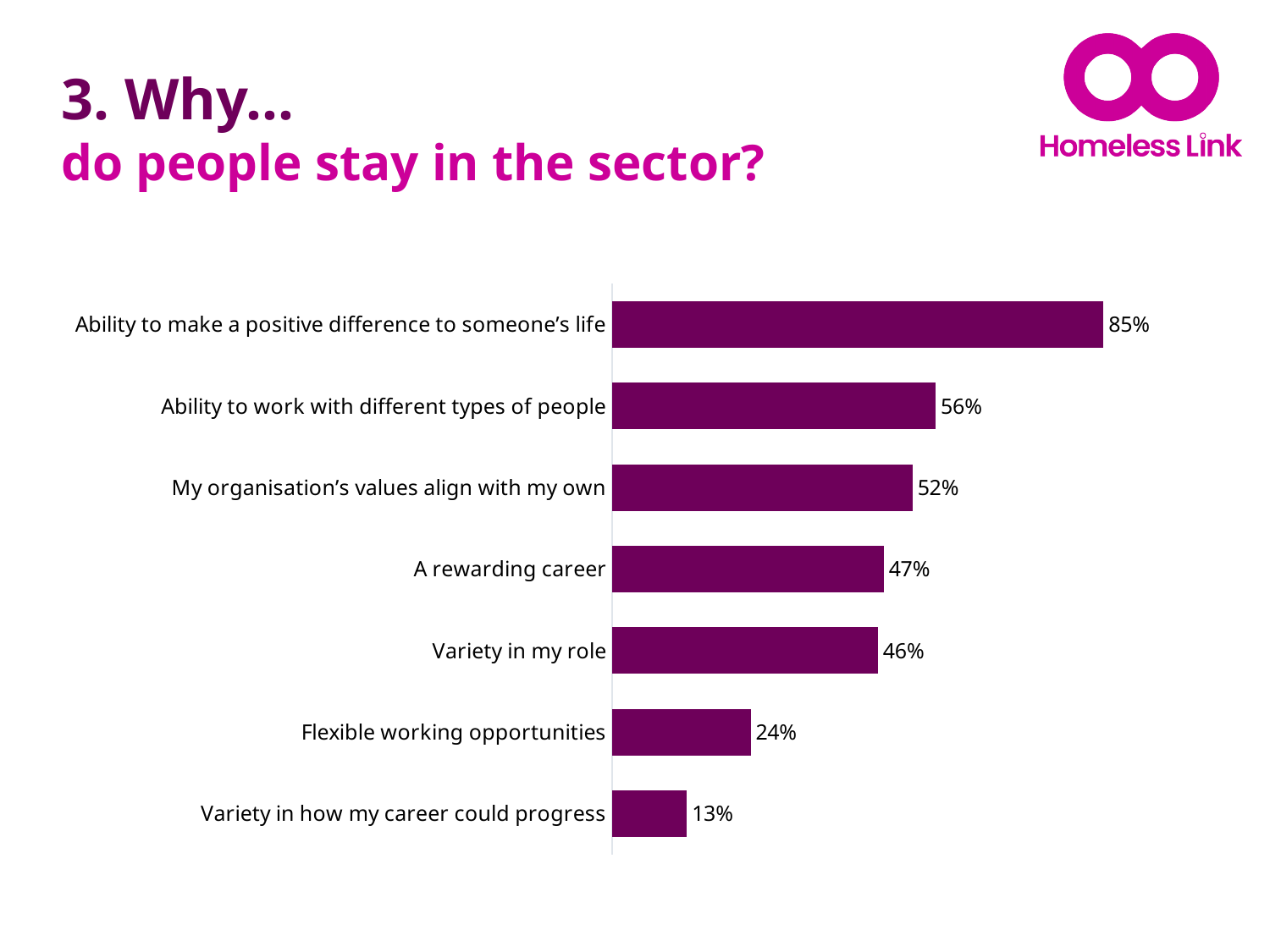
What kind of chart is shown on the slide? Bar chart What is the title of the slide containing the chart? 3. Why… do people stay in the sector? What percentage is shown for 'My organisation's values align with my own'? 52% Which category has the lowest value? Variety in how my career could progress What is the value for 'Flexible working opportunities'? 24% What is the value for 'Variety in my role'? 46% What is the difference between 'Ability to work with different types of people' and 'A rewarding career'? 9% Which category has the highest value? Ability to make a positive difference to someone's life How many categories are shown on the chart? 7 What percentage is shown for 'Ability to make a positive difference to someone's life'? 85% What is the difference between the highest and lowest values on the chart? 72% Which is larger: 'Variety in my role' or 'Flexible working opportunities'? Variety in my role